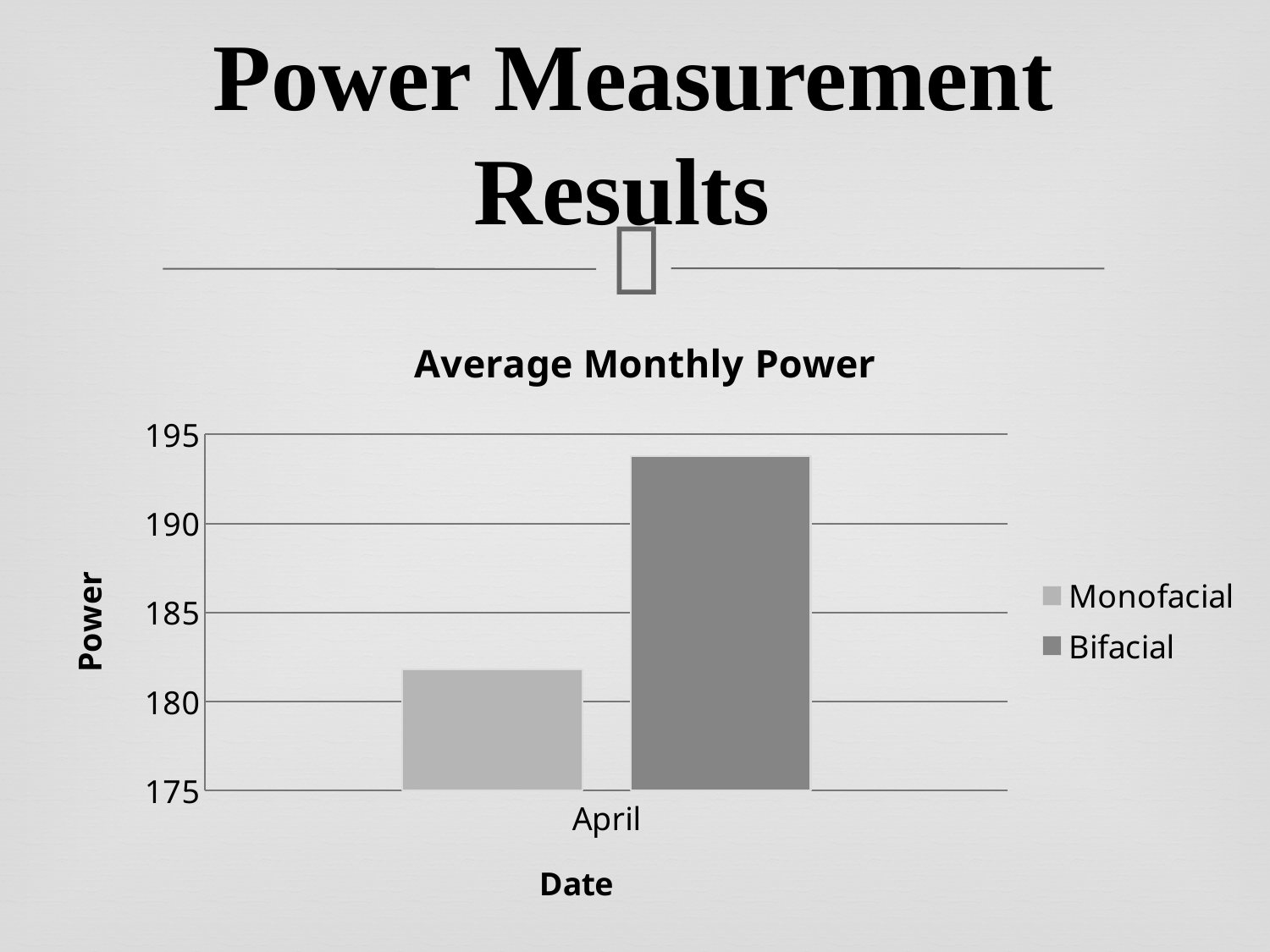
Is the value for Bifacial in April greater or less than 190? greater What kind of chart is shown on the slide? bar chart Is the value for Bifacial in April greater or less than 195? less Which series is shown with the darker bar? Bifacial Is the value for Monofacial in April greater or less than 180? greater What is the label of the x axis? Date Which series has the lowest value in the chart? Monofacial How many series does the legend list? 2 Which series has the higher value for April, Monofacial or Bifacial? Bifacial What is the title of the chart? Average Monthly Power How many categories are shown on the x axis? 1